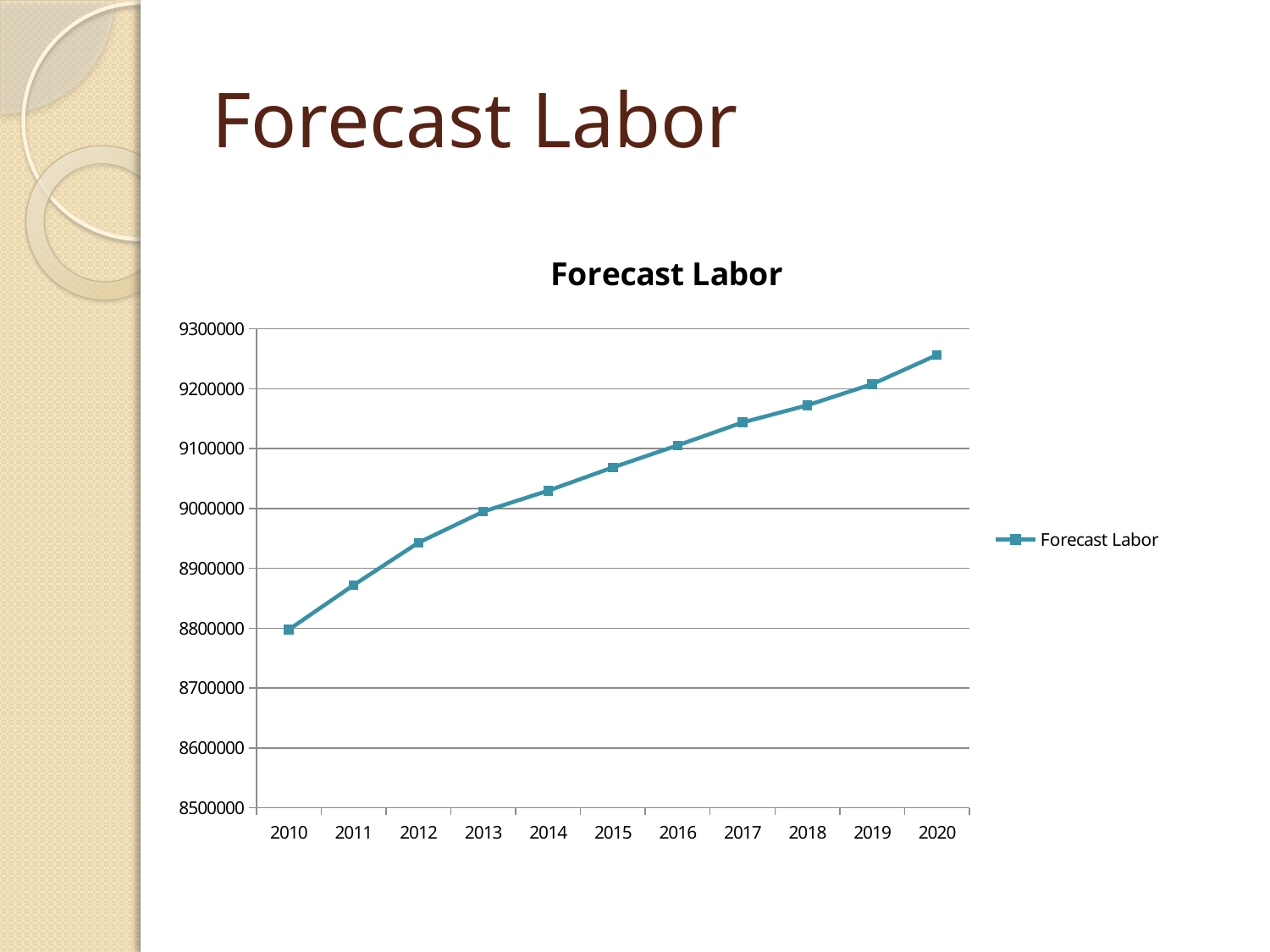
Which year has the larger Forecast Labor value, 2013 or 2016? 2016 Which year has the lowest Forecast Labor value? 2010 Is the Forecast Labor value for 2012 greater or less than 9000000? less How many years are plotted along the x axis? 11 Is the Forecast Labor value for 2015 greater or less than 9000000? greater Do the Forecast Labor values rise or fall from 2010 to 2020? rise Which year has the highest Forecast Labor value? 2020 Is the Forecast Labor value for 2011 greater or less than 8900000? less How many series does the legend list? 1 What kind of chart is shown on the slide? line chart What is the title of the chart? Forecast Labor